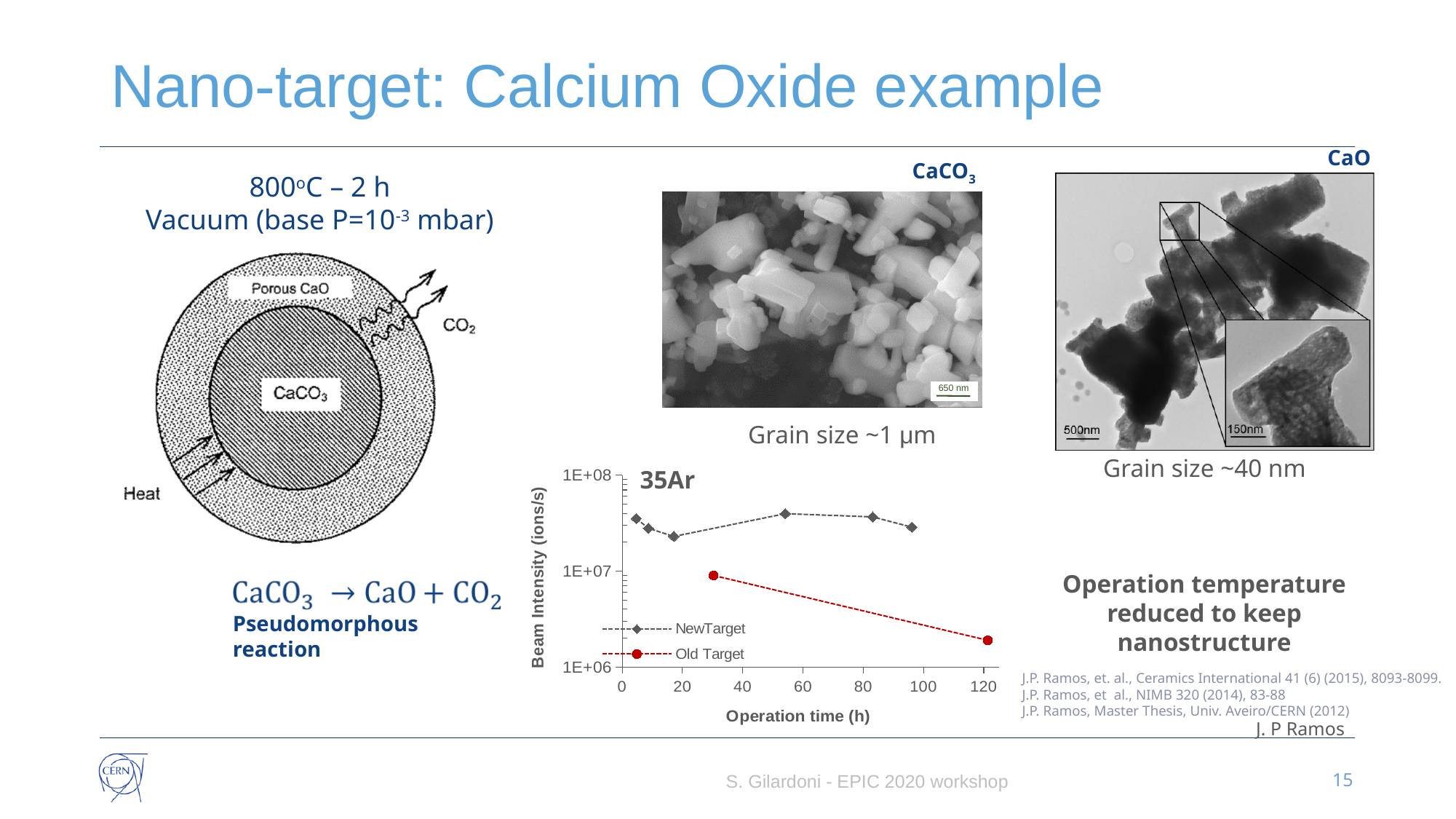
What kind of chart is shown on the slide? line chart How many data points are plotted for the Old Target series? 2 How many series does the chart legend list? 2 What are the two series named in the chart legend? NewTarget and Old Target Is the beam intensity of the Old Target series at about 120 h greater or less than 1E+07 ions/s? less Does the beam intensity of the Old Target series rise or fall as operation time increases? fall Which series reaches the lowest beam intensity on the chart? Old Target Is the beam intensity of the NewTarget series at about 54 h greater or less than 1E+07 ions/s? greater Which series has the higher beam intensity overall, NewTarget or Old Target? NewTarget What is the label of the chart's y axis? Beam Intensity (ions/s) How many data points are plotted for the NewTarget series? 6